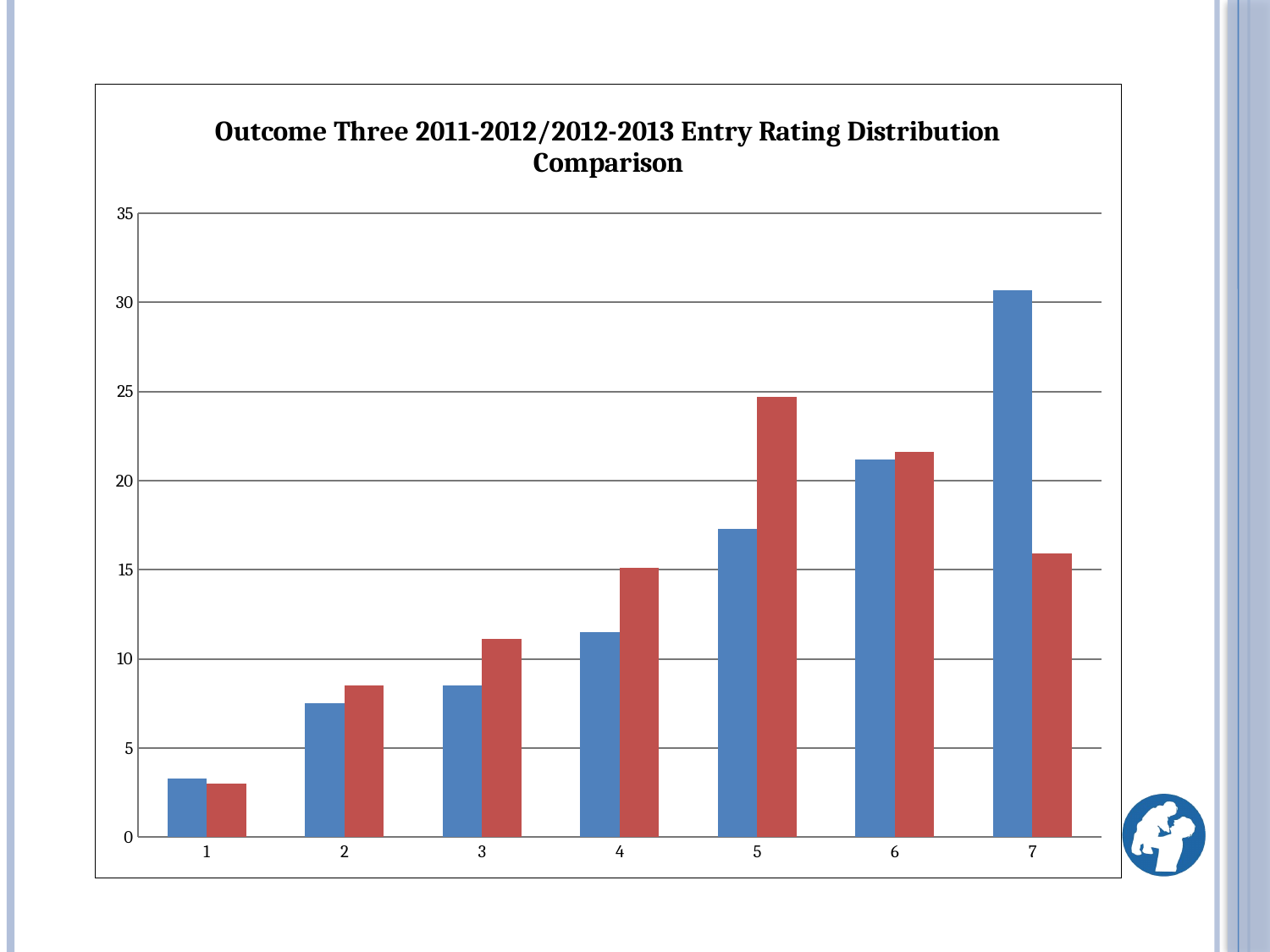
What kind of chart is shown on the slide? bar chart How many categories are shown on the x axis? 7 For which category is the blue bar the shortest? 1 For which category is the red bar the tallest? 5 At category 7, which bar is taller, the blue or the red? blue Is the value of the blue bar for category 7 greater or less than 30? greater Do the blue bars rise or fall as the categories go from 1 to 7? rise At category 5, which bar is taller, the blue or the red? red For which category is the red bar the shortest? 1 For which category is the blue bar the tallest? 7 What is the title of the chart? Outcome Three 2011-2012/2012-2013 Entry Rating Distribution Comparison